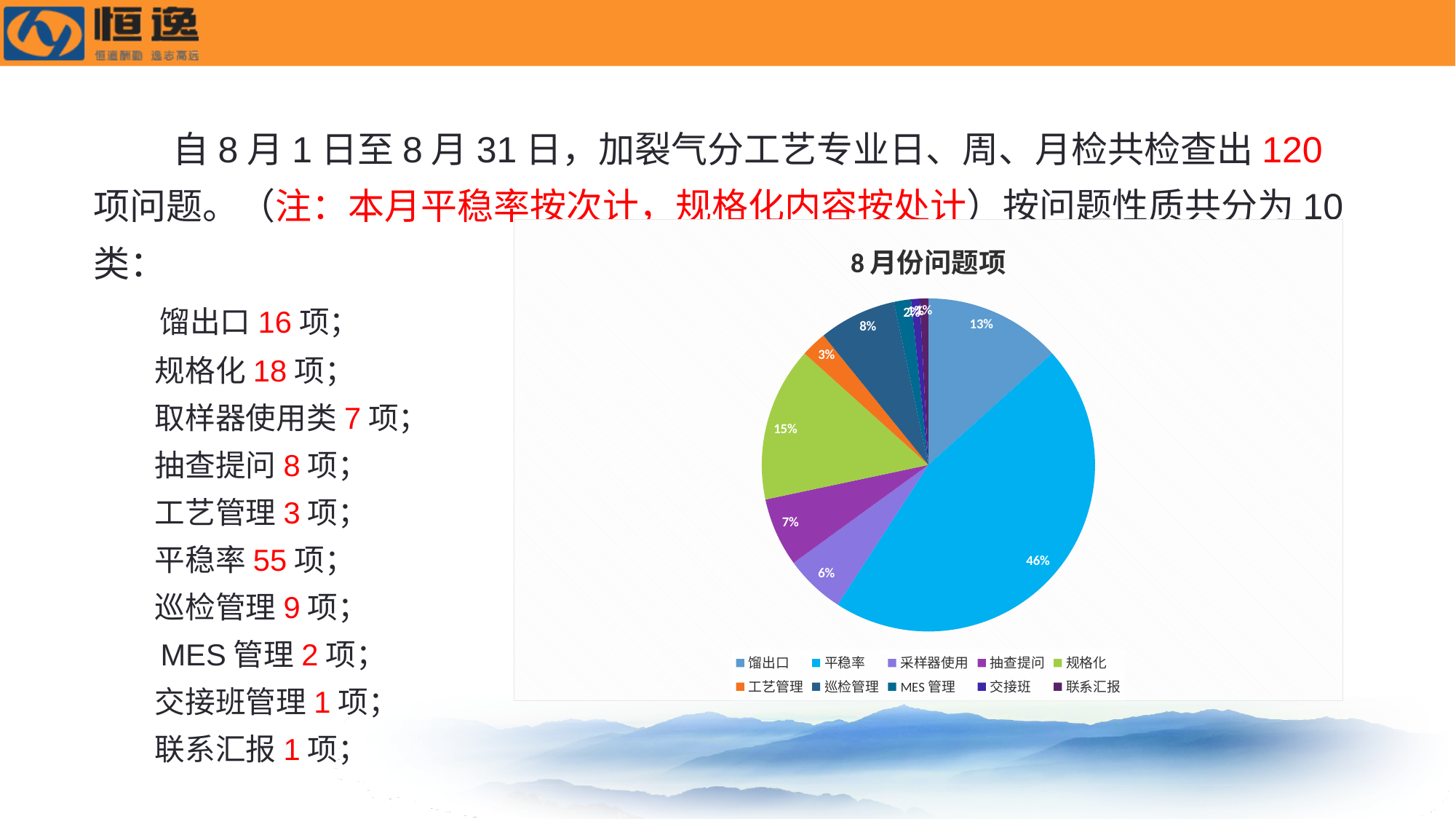
What percentage share does 巡检管理 have in the pie chart? 8% What percentage share does 规格化 have in the pie chart? 15% What is the title of the pie chart? 8月份问题项 What kind of chart is shown on the slide? pie chart What percentage share does 抽查提问 have in the pie chart? 7% How many categories does the legend of the pie chart list? 10 Which slice is larger, 规格化 or 馏出口? 规格化 What is the difference in percentage points between the 平稳率 slice and the 规格化 slice? 31 What percentage share does 馏出口 have in the pie chart? 13% Which category has the largest slice in the pie chart? 平稳率 What percentage share does 平稳率 have in the pie chart? 46% What percentage share does 工艺管理 have in the pie chart? 3%